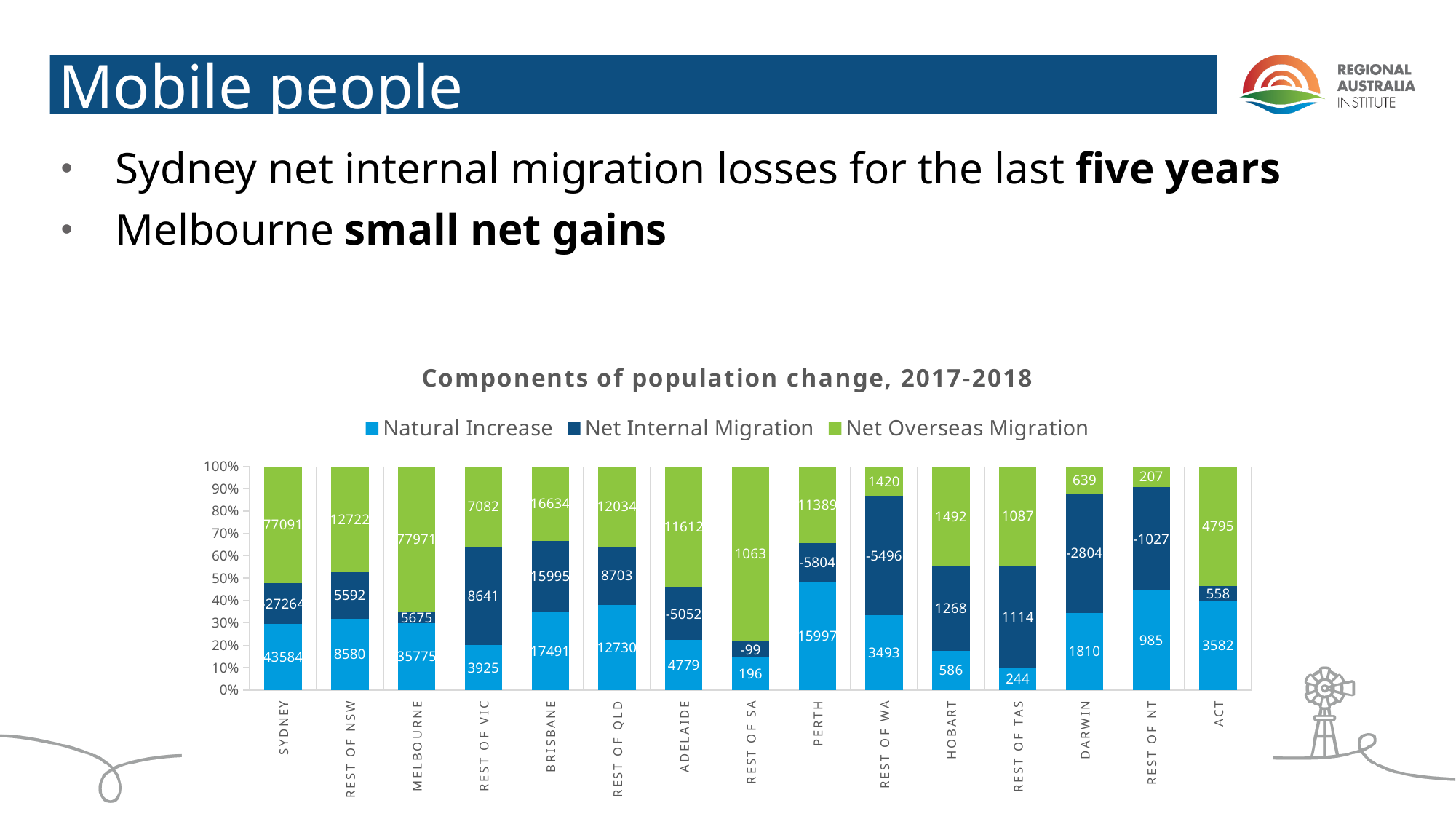
How many regions are shown on the x axis? 15 Which region has the highest Natural Increase value? Sydney What is the Net Overseas Migration value for Melbourne? 77971 What is the Net Internal Migration value for Sydney? -27264 What is the Net Internal Migration value for Rest of WA? -5496 Which has the larger Natural Increase value, Perth or Brisbane? Brisbane How many series does the legend list? 3 What is the difference between the Natural Increase values for Brisbane and Rest of QLD? 4761 What is the title of the chart? Components of population change, 2017-2018 Which region has the lowest Natural Increase value? Rest of SA What kind of chart is shown on the slide? Stacked bar chart Which region has the highest Net Overseas Migration value? Melbourne